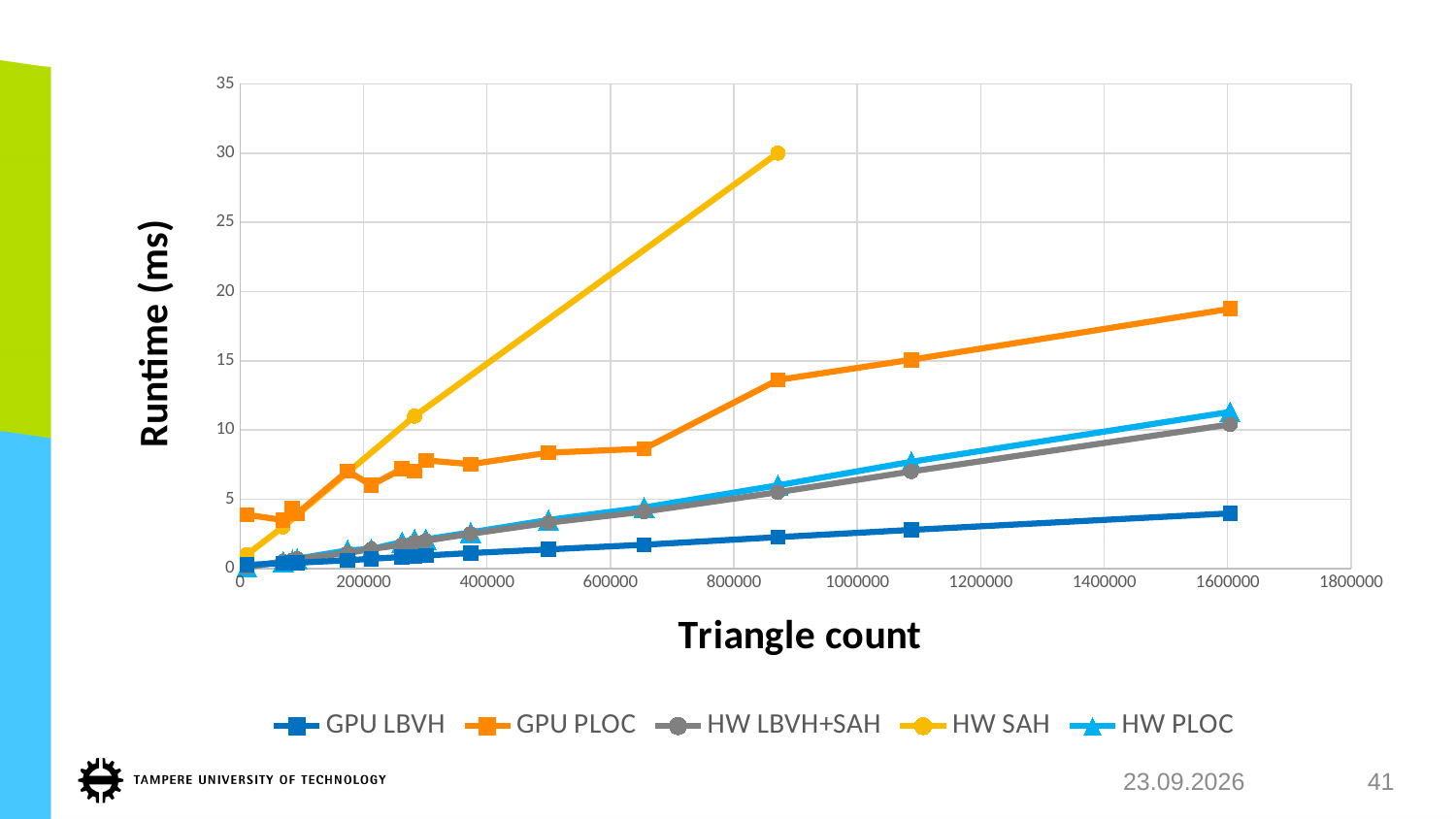
What is the label of the y axis? Runtime (ms) Which series has the highest runtime at about 1600000 triangles? GPU PLOC Is the runtime for HW SAH at its last point (around 870000 triangles) greater or less than 25 ms? greater Does the runtime for GPU PLOC rise or fall as the triangle count increases? rise How many series does the legend list? 5 Which series reaches the highest runtime anywhere on the chart? HW SAH At about 1100000 triangles, which has the larger runtime, GPU PLOC or HW PLOC? GPU PLOC What kind of chart is shown on the slide? line chart What is the label of the x axis? Triangle count Which series has the lowest runtime at about 1600000 triangles? GPU LBVH Is the runtime for GPU LBVH at about 1600000 triangles greater or less than 5 ms? less Is the runtime for GPU PLOC at about 1600000 triangles greater or less than 15 ms? greater